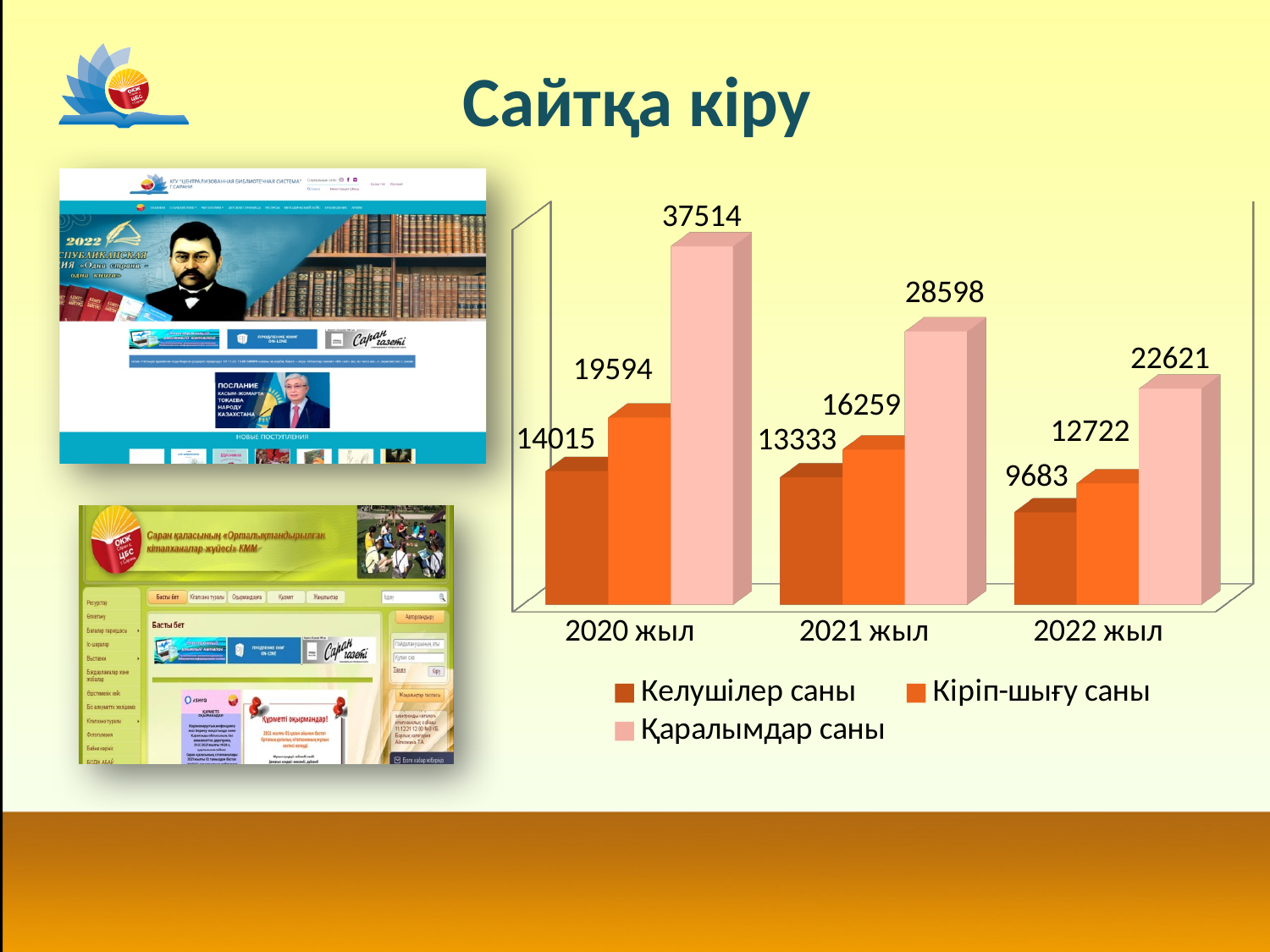
What is the difference between Қаралымдар саны in 2020 жыл and 2021 жыл? 8916 How many year categories are shown on the x axis? 3 What is the value of Кіріп-шығу саны for 2021 жыл? 16259 In which year is Қаралымдар саны highest? 2020 жыл What is the value of Келушілер саны for 2022 жыл? 9683 How many series does the legend list? 3 What is the difference between Кіріп-шығу саны and Келушілер саны in 2022 жыл? 3039 What kind of chart is shown on the slide? Bar chart In which year is Келушілер саны lowest? 2022 жыл Which is larger in 2021 жыл: Келушілер саны or Кіріп-шығу саны? Кіріп-шығу саны What is the value of Қаралымдар саны for 2020 жыл? 37514 Do the Қаралымдар саны values rise or fall from 2020 жыл to 2022 жыл? Fall